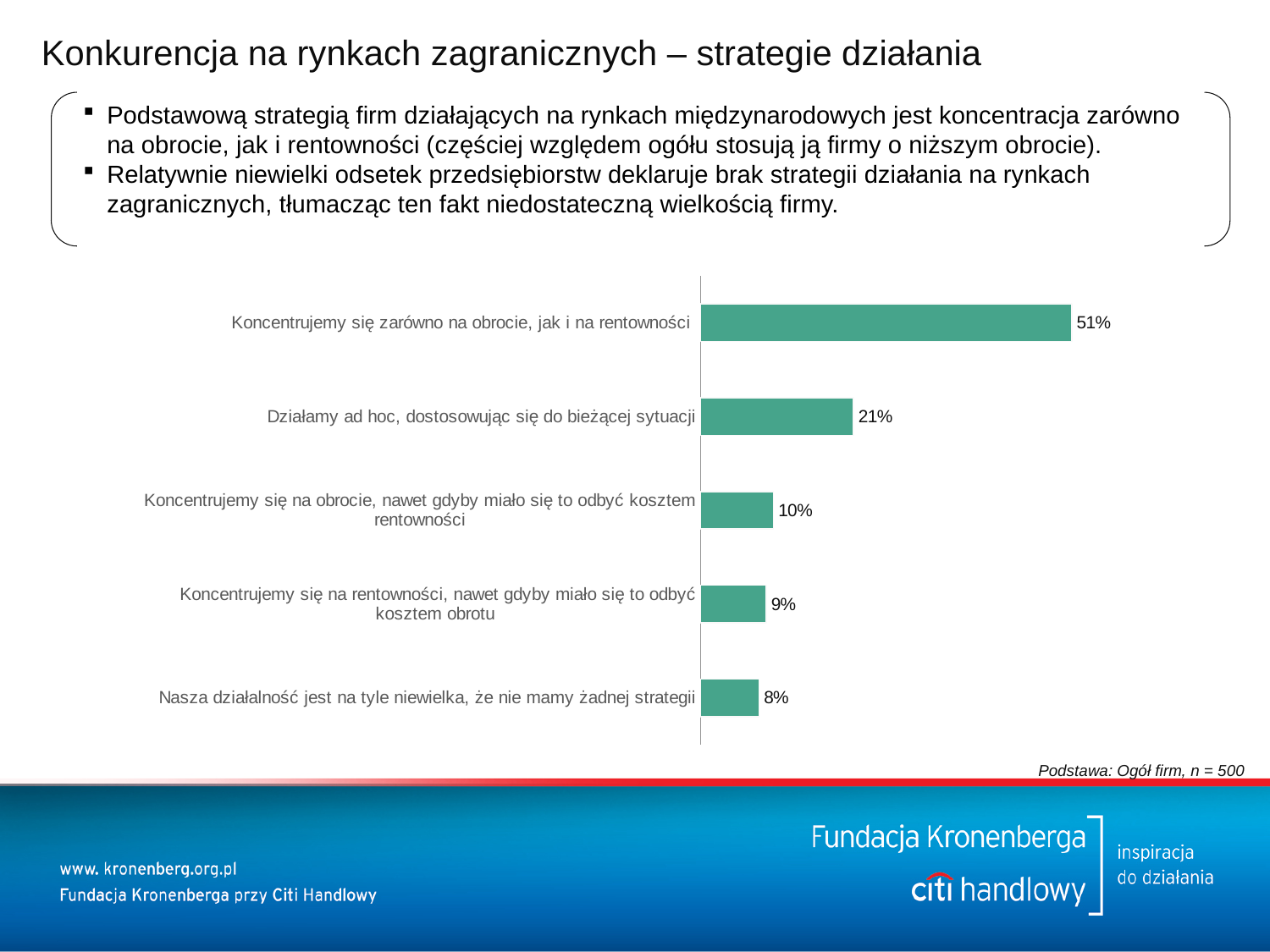
What is the value for "Koncentrujemy się na rentowności, nawet gdyby miało się to odbyć kosztem obrotu"? 9% What is the value for "Nasza działalność jest na tyle niewielka, że nie mamy żadnej strategii"? 8% What is the value for "Koncentrujemy się zarówno na obrocie, jak i na rentowności"? 51% What is the difference between the values for "Koncentrujemy się zarówno na obrocie, jak i na rentowności" and "Działamy ad hoc, dostosowując się do bieżącej sytuacji"? 30% Which category has the highest value? Koncentrujemy się zarówno na obrocie, jak i na rentowności Which category has the lowest value? Nasza działalność jest na tyle niewielka, że nie mamy żadnej strategii How many categories are shown in the chart? 5 Which is larger: the value for "Działamy ad hoc, dostosowując się do bieżącej sytuacji" or for "Koncentrujemy się na obrocie, nawet gdyby miało się to odbyć kosztem rentowności"? Działamy ad hoc, dostosowując się do bieżącej sytuacji What is the difference between the values for "Koncentrujemy się na obrocie, nawet gdyby miało się to odbyć kosztem rentowności" and "Nasza działalność jest na tyle niewielka, że nie mamy żadnej strategii"? 2% What kind of chart is shown on the slide? Bar chart What is the value for "Działamy ad hoc, dostosowując się do bieżącej sytuacji"? 21% What is the base (Podstawa) stated below the chart? Ogół firm, n = 500